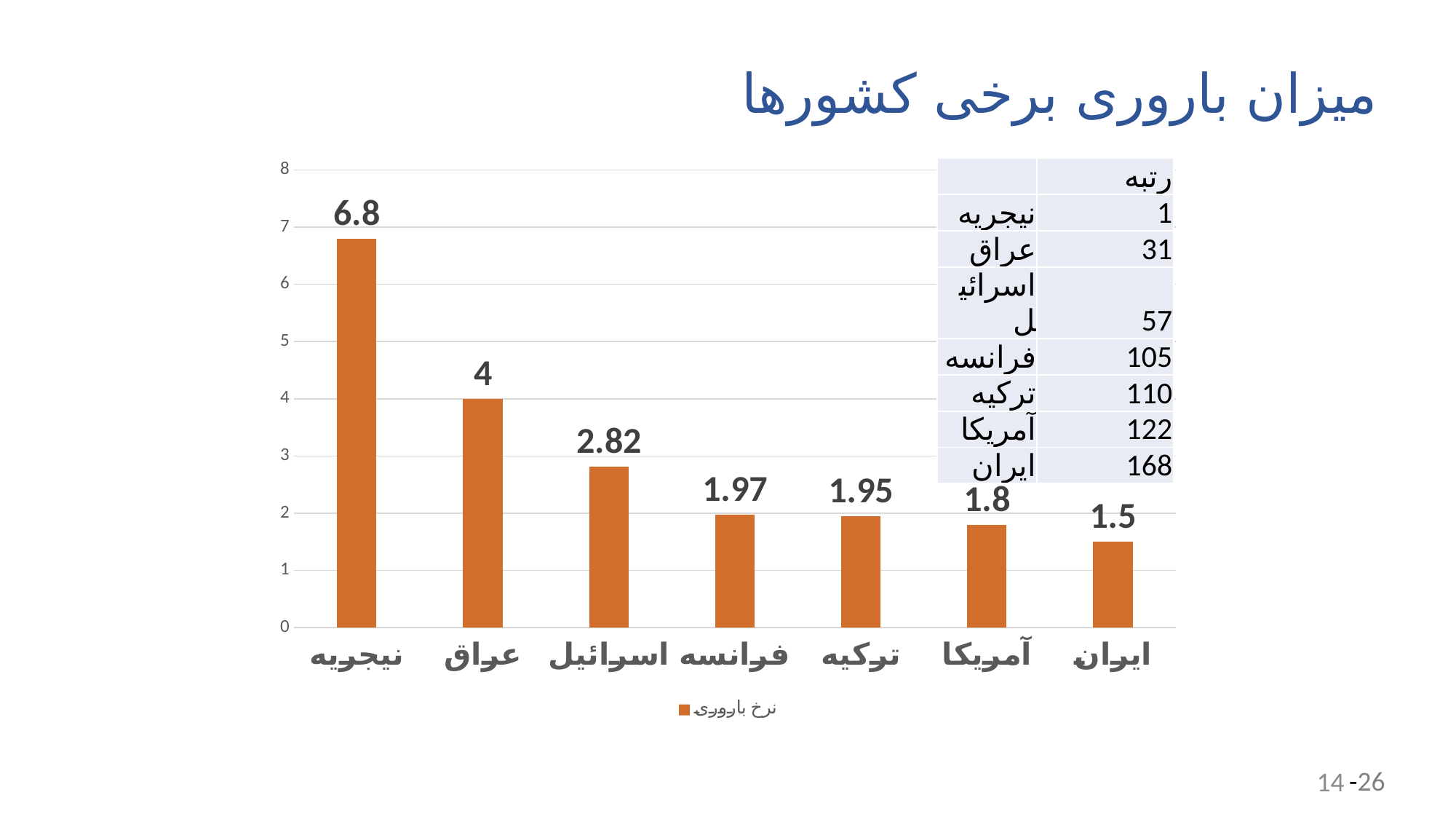
Which is larger, the value for عراق (Iraq) or the value for اسرائیل (Israel)? عراق What is the fertility rate value shown for نیجریه (Nigeria)? 6.8 What is the difference between the values for آمریکا (USA) and ایران (Iran)? 0.3 What is the value shown for اسرائیل (Israel)? 2.82 What kind of chart is shown on the slide? bar chart How many countries are shown in the chart? 7 Is the value for فرانسه (France) greater or less than 2? less What series name does the legend show? نرخ باروری Which country has the lowest bar in the chart? ایران What is the value shown for ایران (Iran)? 1.5 Which country has the highest bar in the chart? نیجریه What is the difference between the values for نیجریه (Nigeria) and عراق (Iraq)? 2.8